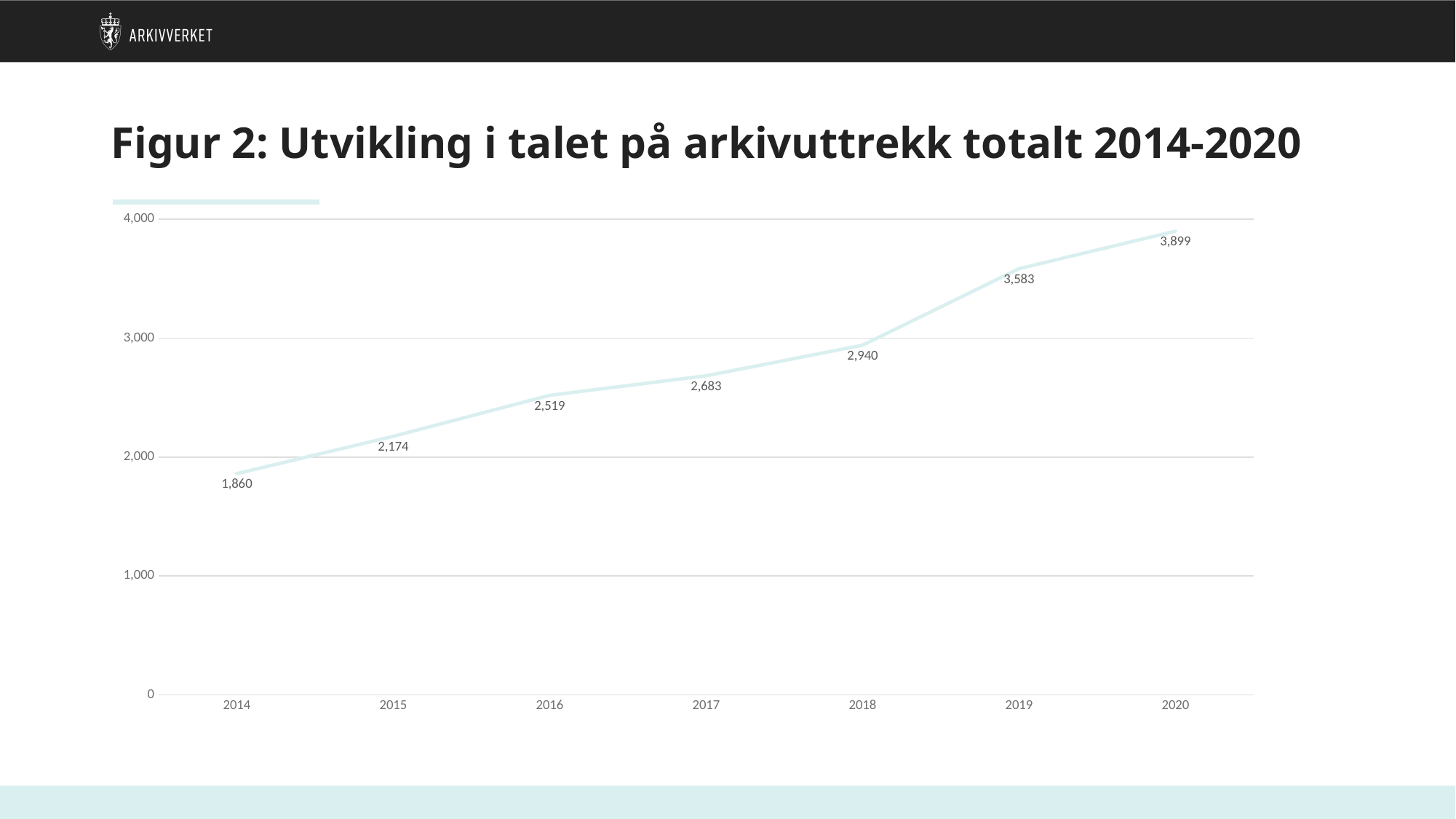
What is the value for 2017? 2,683 What is the value for 2014? 1,860 Is the value for 2015 greater or less than 2,000? greater What is the difference between the values for 2020 and 2019? 316 Do the values rise or fall from 2014 to 2020? rise Which is larger, the value for 2016 or the value for 2018? 2018 Which year has the highest value? 2020 What kind of chart is shown? line chart What is the value for 2020? 3,899 What is the difference between the values for 2018 and 2014? 1,080 Which year has the lowest value? 2014 How many years are plotted on the x axis? 7